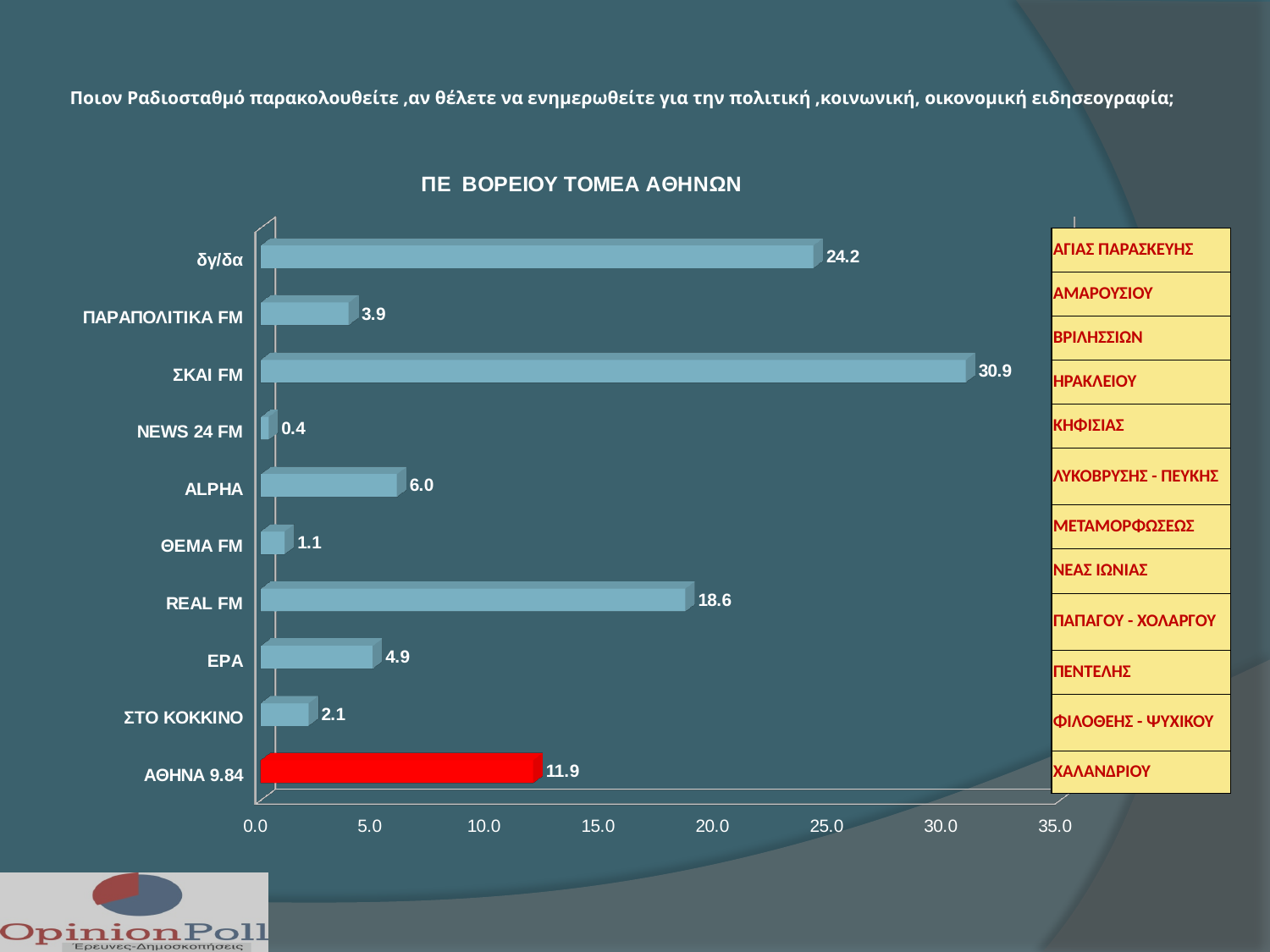
What is the value for ΣΚΑΙ FM? 30.9 Which is larger, the value for ALPHA or the value for ΕΡΑ? ALPHA Which category has the highest value? ΣΚΑΙ FM What is the difference between the values for ΣΚΑΙ FM and δγ/δα? 6.7 What is the value for REAL FM? 18.6 Which category has the lowest value? NEWS 24 FM Is the value for REAL FM greater or less than 20.0? less Which bar is coloured red rather than blue? ΑΘΗΝΑ 9.84 How many categories are shown on the chart? 10 What kind of chart is shown on the slide? bar chart What is the title of the chart? ΠΕ ΒΟΡΕΙΟΥ ΤΟΜΕΑ ΑΘΗΝΩΝ What is the value for ΑΘΗΝΑ 9.84? 11.9